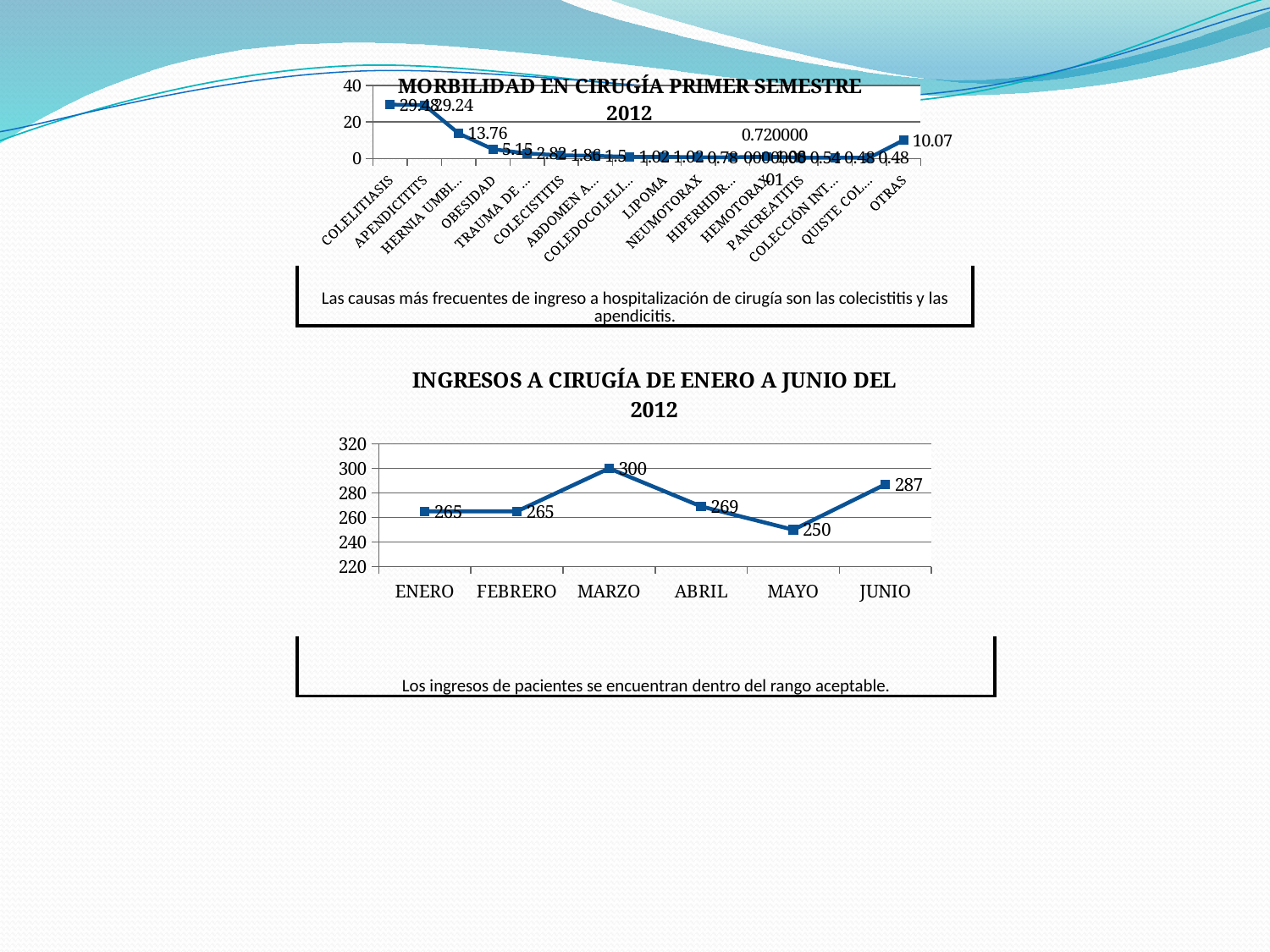
In the top chart titled 'MORBILIDAD EN CIRUGÍA PRIMER SEMESTRE 2012', what is the value for OTRAS? 10.07 How many months are plotted in the chart titled 'INGRESOS A CIRUGÍA DE ENERO A JUNIO DEL 2012'? 6 In the chart titled 'INGRESOS A CIRUGÍA DE ENERO A JUNIO DEL 2012', what is the value for JUNIO? 287 In the chart titled 'INGRESOS A CIRUGÍA DE ENERO A JUNIO DEL 2012', do the values rise or fall from ABRIL to MAYO? Fall In the chart titled 'INGRESOS A CIRUGÍA DE ENERO A JUNIO DEL 2012', which is larger, the value for ABRIL or the value for JUNIO? JUNIO In the chart titled 'INGRESOS A CIRUGÍA DE ENERO A JUNIO DEL 2012', which month has the highest value? MARZO In the chart titled 'INGRESOS A CIRUGÍA DE ENERO A JUNIO DEL 2012', which month has the lowest value? MAYO In the chart titled 'INGRESOS A CIRUGÍA DE ENERO A JUNIO DEL 2012', what is the difference between the values for MARZO and MAYO? 50 In the top chart titled 'MORBILIDAD EN CIRUGÍA PRIMER SEMESTRE 2012', is the value for COLELITIASIS greater or less than 20? greater In the chart titled 'INGRESOS A CIRUGÍA DE ENERO A JUNIO DEL 2012', what is the value for MARZO? 300 In the chart titled 'INGRESOS A CIRUGÍA DE ENERO A JUNIO DEL 2012', what is the value for MAYO? 250 What kind of chart is the chart titled 'INGRESOS A CIRUGÍA DE ENERO A JUNIO DEL 2012'? Line chart